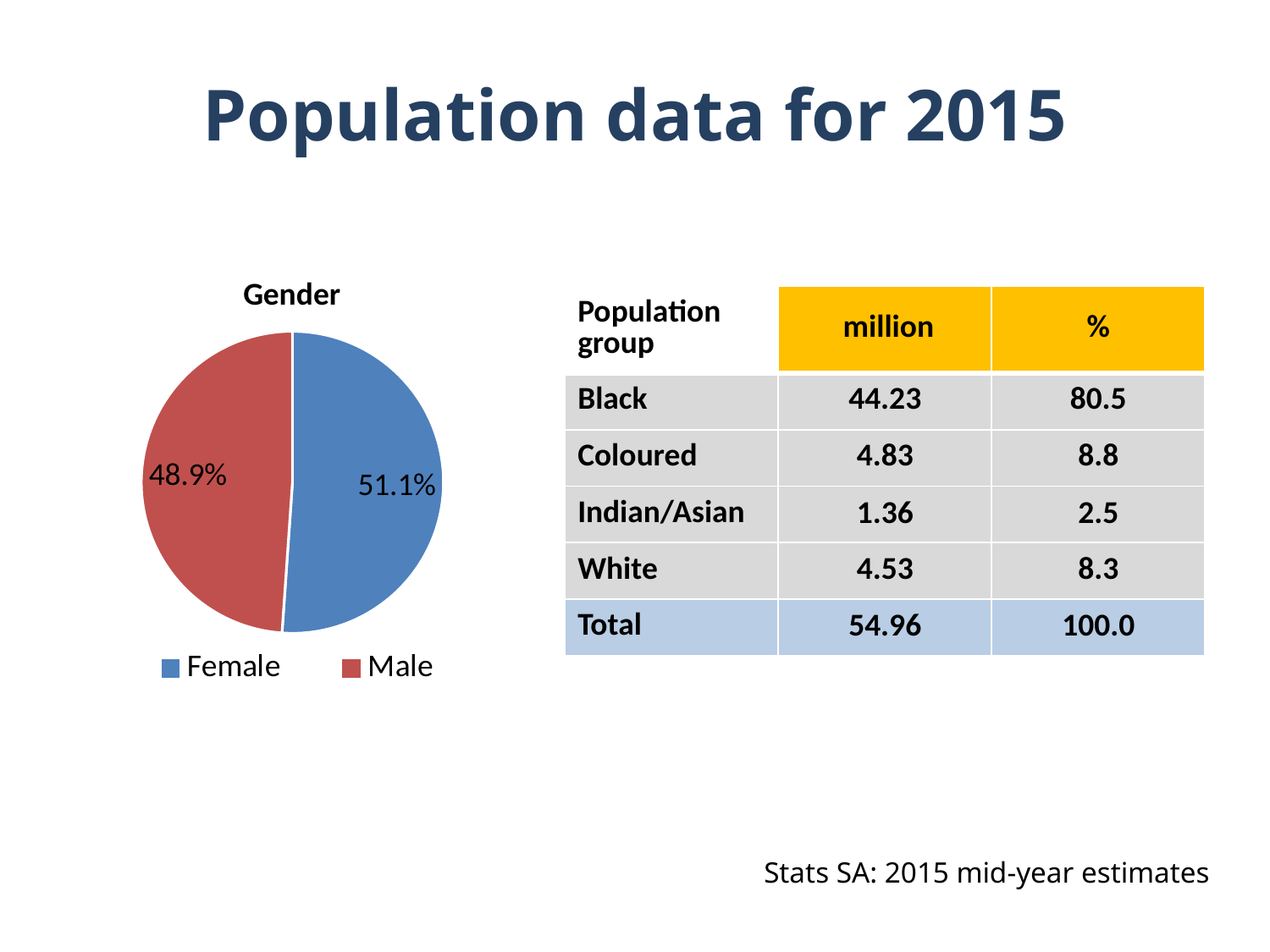
What kind of chart is the "Gender" chart? pie chart What is the title of the pie chart? Gender How many entries does the legend of the "Gender" pie chart list? 2 In the "Gender" pie chart, which is larger, Female or Male? Female What is the share for Male in the "Gender" pie chart? 48.9% In the "Gender" pie chart, what is the difference between the Female and Male shares? 2.2% What is the share for Female in the "Gender" pie chart? 51.1% Which slice is the smallest in the "Gender" pie chart? Male How many slices does the "Gender" pie chart have? 2 What colour is the Female slice in the "Gender" pie chart? blue Which slice is the largest in the "Gender" pie chart? Female